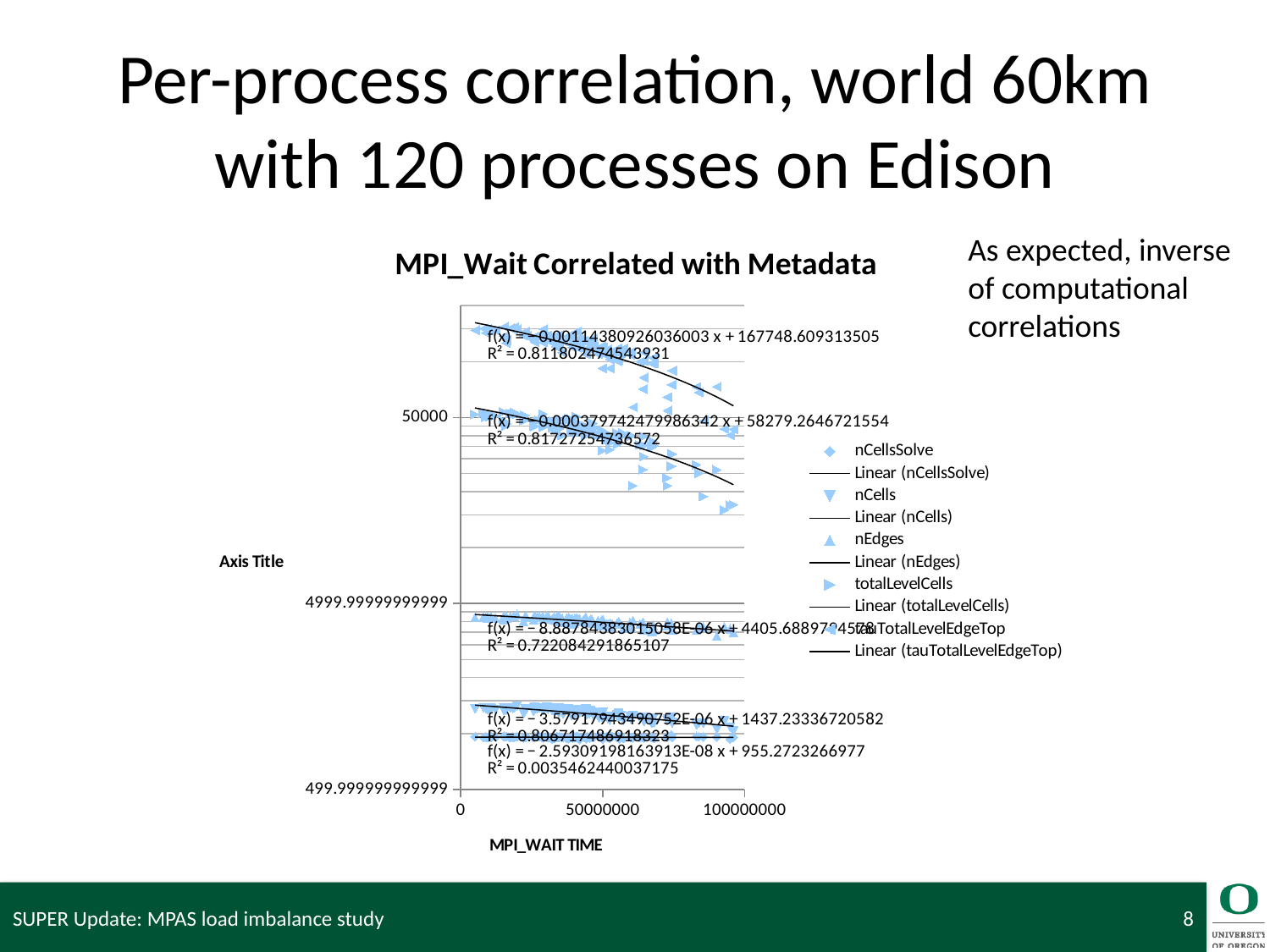
How many data series (excluding the linear trendlines) does the legend list? 5 What is the highest tick value shown on the y axis? 50000 Do the plotted values rise or fall as MPI_WAIT TIME increases along the x axis? fall How many entries does the chart's legend list? 10 What is the label of the x axis of the chart? MPI_WAIT TIME What is the R² value printed for the topmost trendline on the chart? 0.811802474543931 What is the largest tick value shown on the x axis? 100000000 What is the R² value printed for the bottom-most trendline on the chart? 0.0035462440037175 What is the title of the chart? MPI_Wait Correlated with Metadata Is the slope of every printed trendline equation positive or negative? negative Which legend entry is listed first in the chart's legend? nCellsSolve What kind of chart is shown on the slide? scatter chart